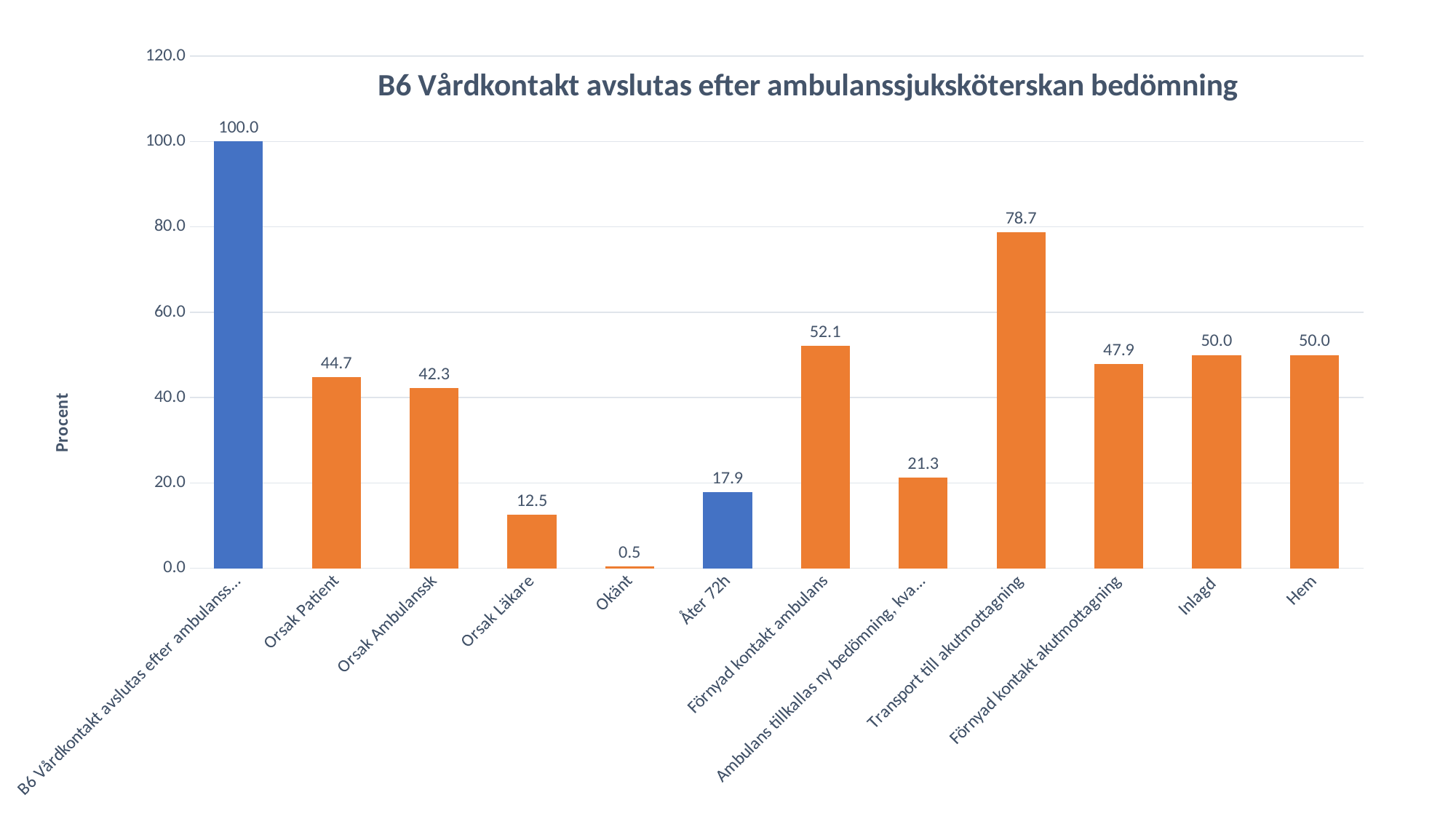
What is the value for Okänt? 0.5 Which is larger, the value for Orsak Patient or the value for Orsak Ambulanssk? Orsak Patient What kind of chart is shown on the slide? Bar chart What is the title of the chart? B6 Vårdkontakt avslutas efter ambulanssjuksköterskan bedömning What is the value for Orsak Patient? 44.7 What is the label of the y axis? Procent What is the difference between the values for Transport till akutmottagning and Orsak Läkare? 66.2 How many bars are shown in the chart? 12 What is the difference between the values for Förnyad kontakt ambulans and Förnyad kontakt akutmottagning? 4.2 Which category has the lowest value? Okänt What is the value for Åter 72h? 17.9 What is the value for Transport till akutmottagning? 78.7